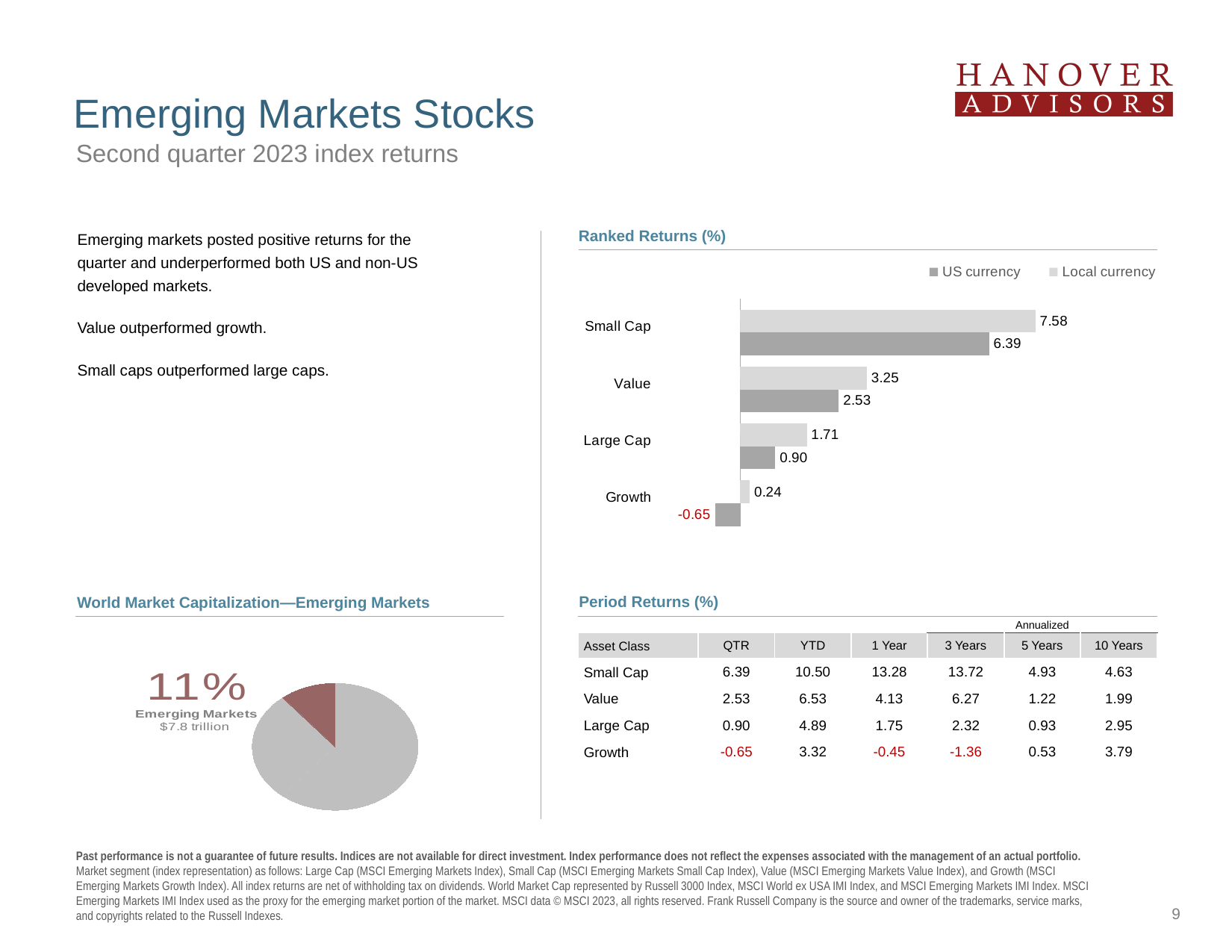
How many categories are shown in the Ranked Returns (%) chart? 4 In the Ranked Returns (%) chart, which category has the highest Local currency return? Small Cap In the Ranked Returns (%) chart, which category has the lowest US currency return? Growth What kind of chart is the World Market Capitalization—Emerging Markets chart? Pie chart In the Ranked Returns (%) chart, which is larger: the US currency return for Value or the Local currency return for Large Cap? US currency return for Value In the Ranked Returns (%) chart, what is the US currency return for Small Cap? 6.39 What kind of chart is the Ranked Returns (%) chart? Bar chart In the Ranked Returns (%) chart, what is the US currency return for Growth? -0.65 In the Ranked Returns (%) chart, what is the difference between the Local currency and US currency returns for Large Cap? 0.81 In the World Market Capitalization—Emerging Markets chart, what share of world market capitalization do Emerging Markets represent? 11% In the Ranked Returns (%) chart, what is the Local currency return for Value? 3.25 How many series does the legend of the Ranked Returns (%) chart list? 2